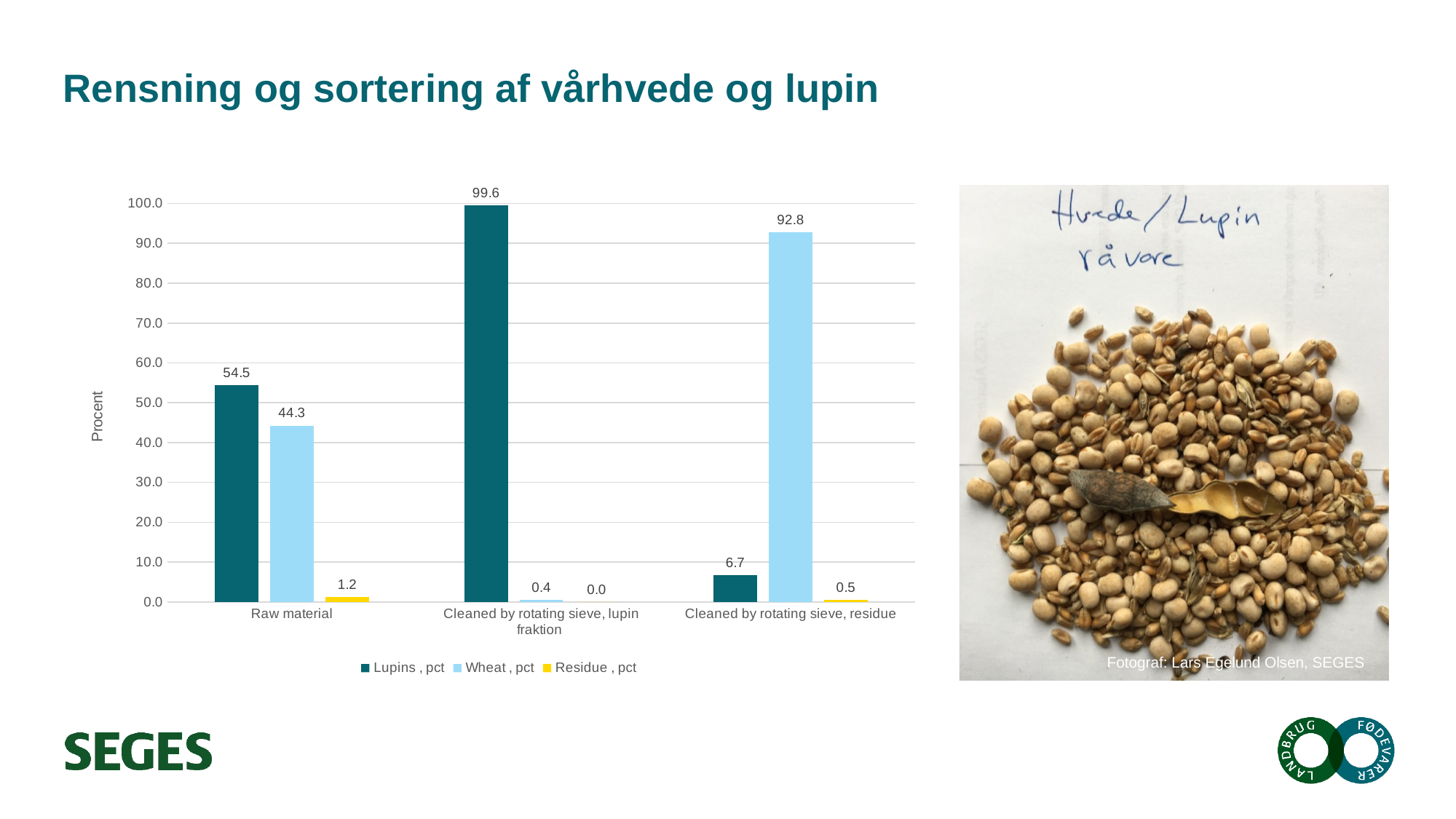
What is the value for Lupins, pct in the Raw material category? 54.5 What is the value for Wheat, pct in the 'Cleaned by rotating sieve, lupin fraktion' category? 0.4 Which category has the highest value for Lupins, pct? Cleaned by rotating sieve, lupin fraktion What is the value for Residue, pct in the Raw material category? 1.2 How many series does the legend list? 3 What is the value for Wheat, pct in the 'Cleaned by rotating sieve, residue' category? 92.8 What kind of chart is shown on the slide? Bar chart What is the label of the vertical axis? Procent How many categories are shown on the x axis? 3 What is the difference between the Lupins, pct value and the Wheat, pct value in the Raw material category? 10.2 Which category has the lowest value for Wheat, pct? Cleaned by rotating sieve, lupin fraktion In the 'Cleaned by rotating sieve, residue' category, which is larger: Lupins, pct or Wheat, pct? Wheat, pct